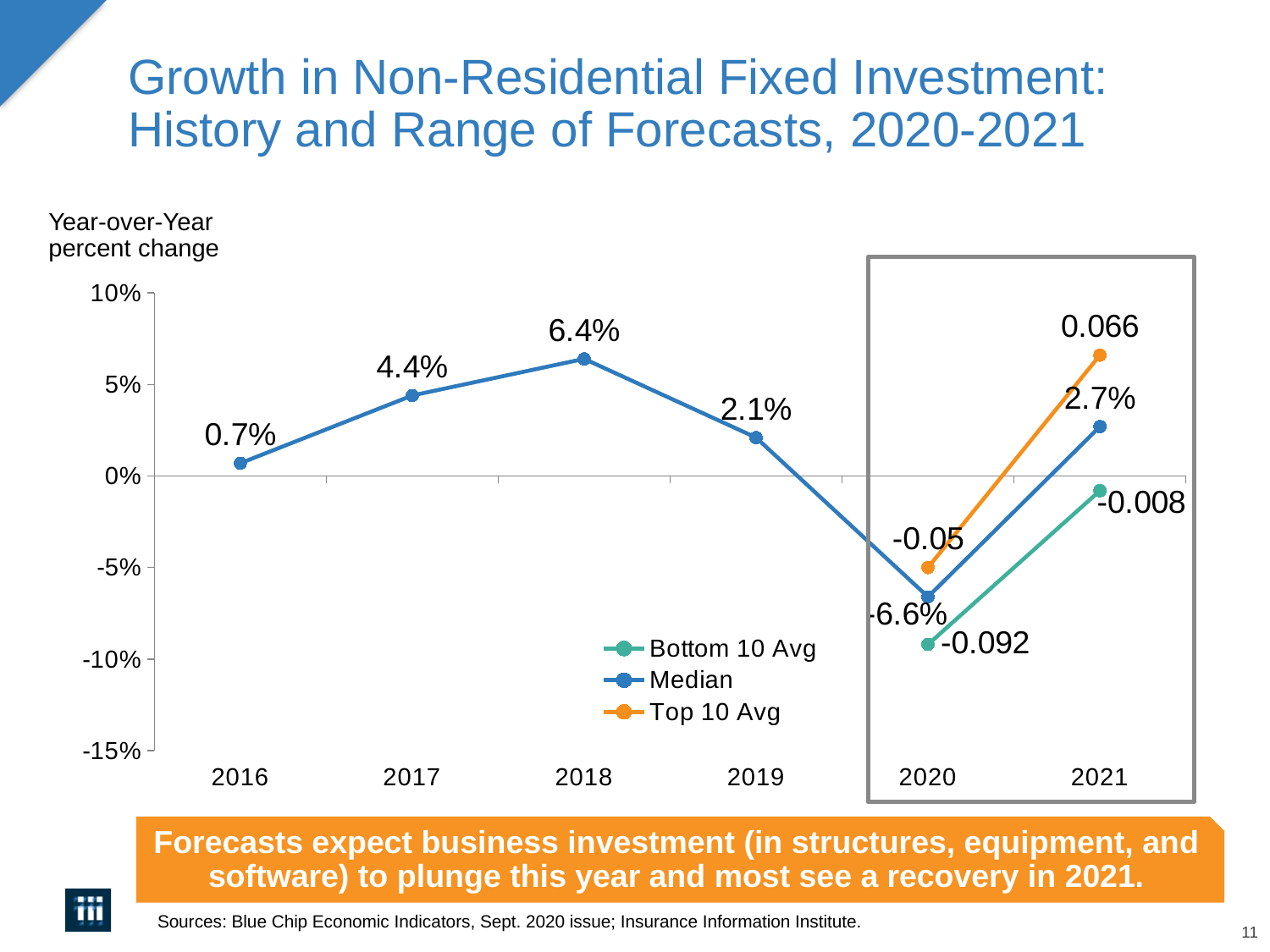
What is the Top 10 Avg value for 2021? 0.066 Which is larger, the Median value for 2017 or for 2019? 2017 What is the Median value for 2018? 6.4% What kind of chart is shown on the slide? Line chart In which year is the Median series lowest? 2020 Does the Median series rise or fall from 2018 to 2020? Fall In which year is the Median series highest? 2018 What is the difference between the Median values for 2018 and 2017? 2.0% What is the Median value for 2020? -6.6% How many years are shown on the x axis? 6 What is the Bottom 10 Avg value for 2020? -0.092 How many series does the legend list? 3